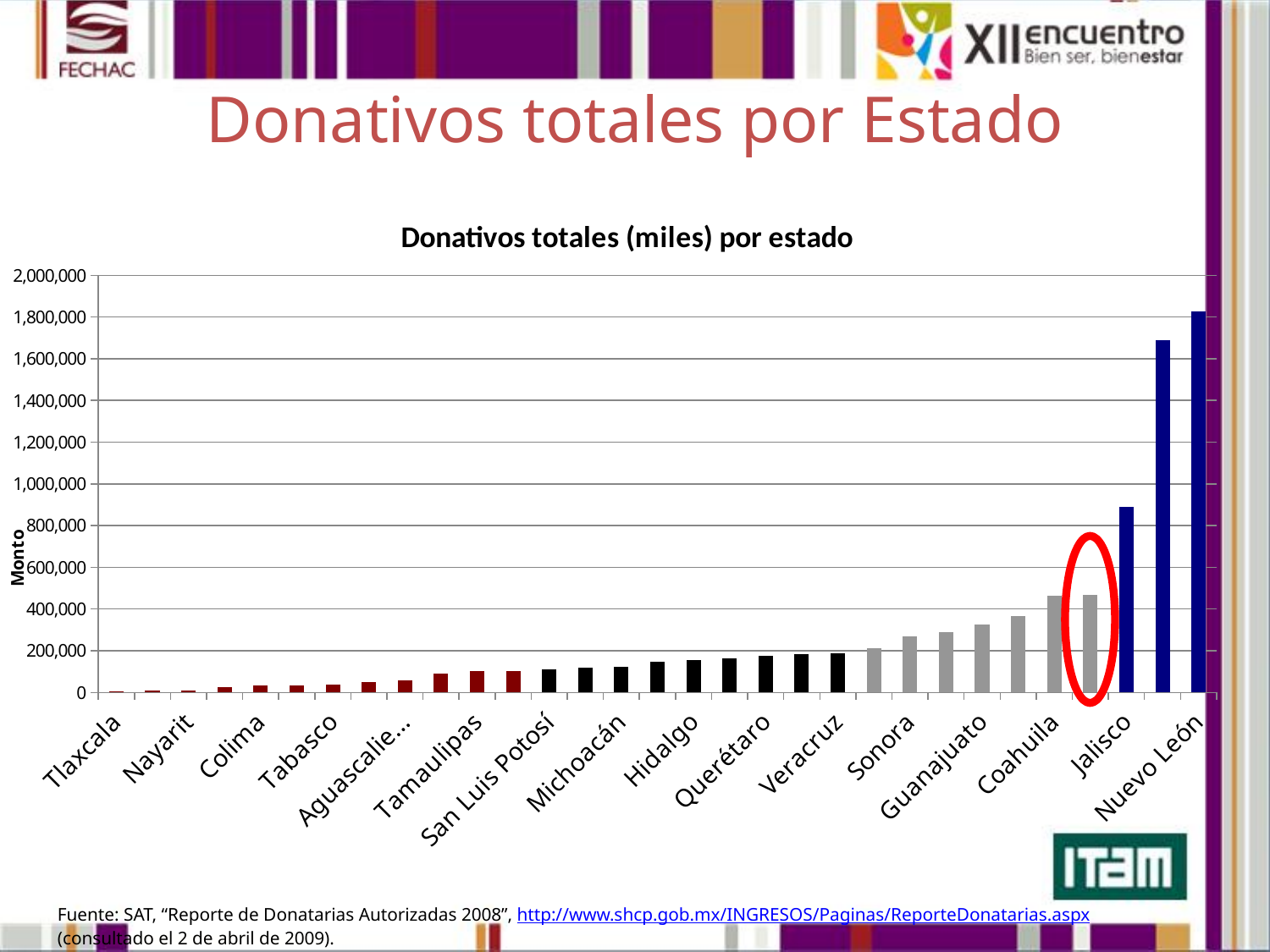
Is the value for Jalisco greater or less than 1,000,000? less What is the title of the chart? Donativos totales (miles) por estado Is the value for Hidalgo greater or less than 200,000? less Which labeled state has the lowest total donations in the chart? Tlaxcala What is the label on the vertical axis of the chart? Monto Is the value for Jalisco greater or less than 800,000? greater Which has a larger value, Jalisco or Coahuila? Jalisco What kind of chart is shown on the slide? Bar chart Do the bar values rise or fall moving from left to right along the x axis? Rise Which state has the highest total donations in the chart? Nuevo León